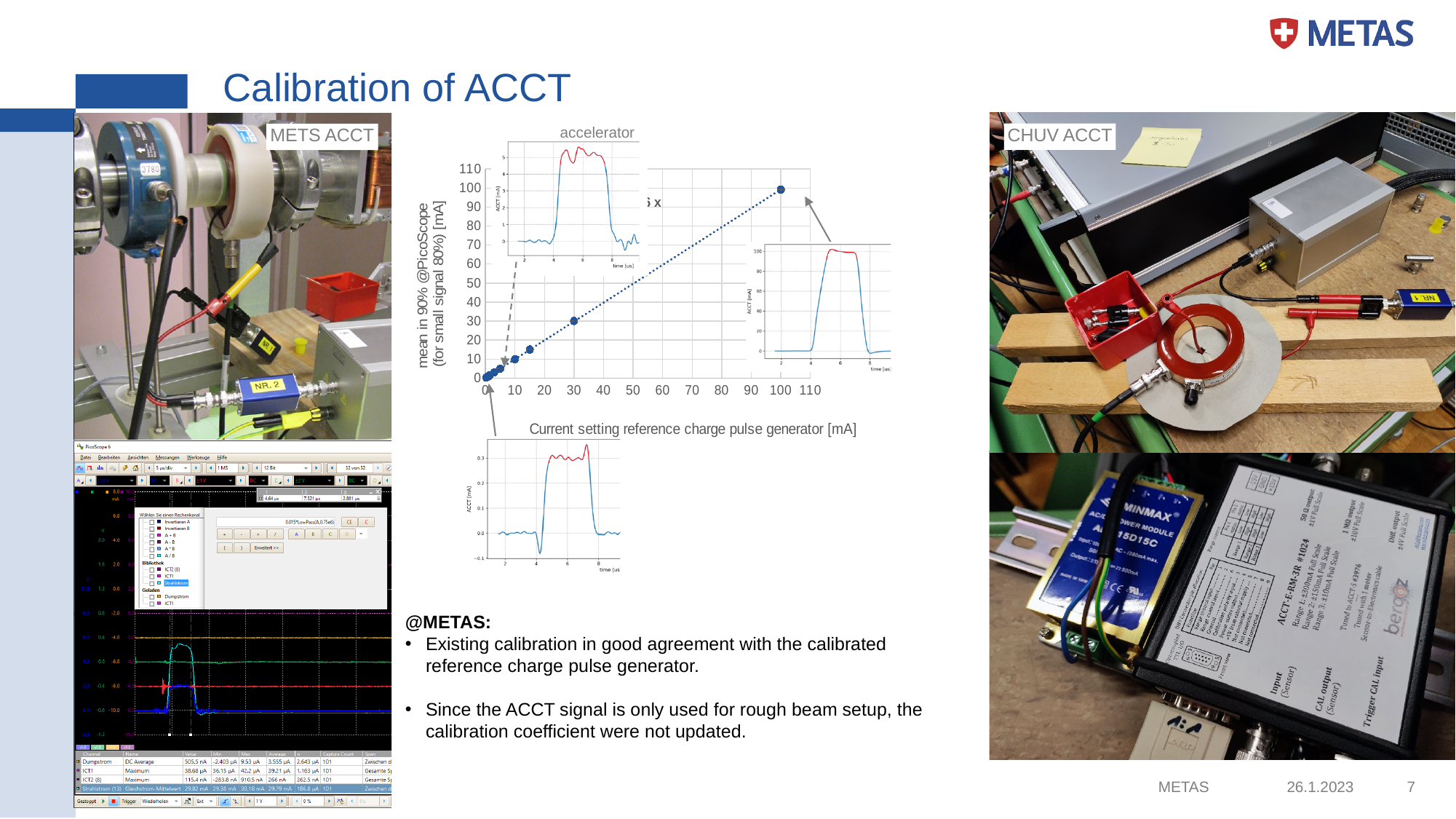
What is the highest tick value shown on the y-axis of the central chart? 110 In the central chart, at which generator current setting is the highest measured value plotted? 100 What is the x-axis title of the central chart? Current setting reference charge pulse generator [mA] In the central chart, is the measured value at a generator setting of 15 mA greater or less than 20? less In the central chart, is the measured value at a generator setting of 30 mA greater or less than 20? greater What kind of chart is the main plot in the centre of the slide? scatter chart In the central chart, is the measured value at a generator setting of 30 mA greater or less than 40? less In the central chart, do the plotted values rise or fall as the current setting of the reference charge pulse generator increases? rise In the central chart, which plotted point has the highest measured value: the one at 30 mA or the one at 100 mA? 100 mA